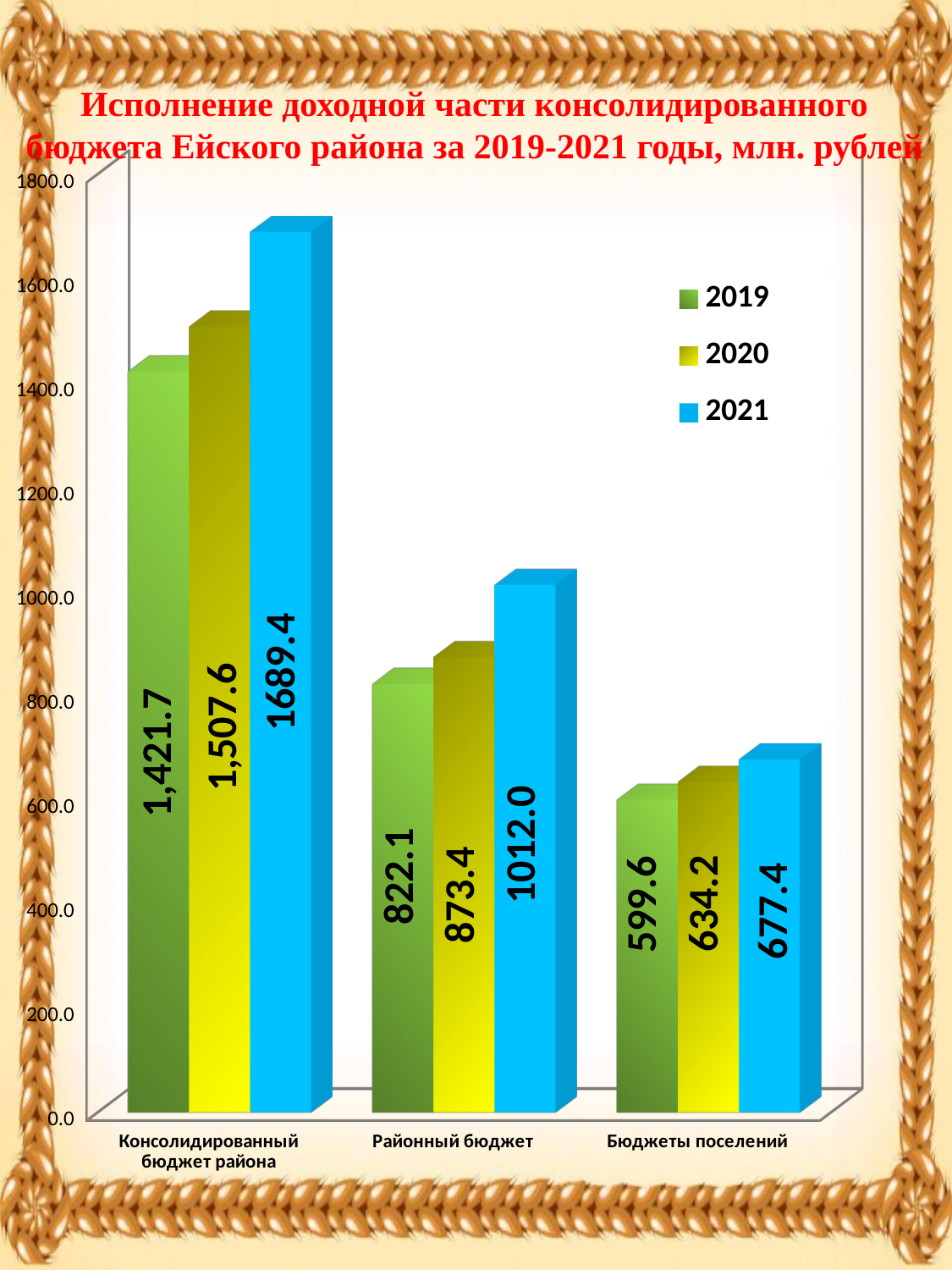
Which category has the highest value for 2019? Консолидированный бюджет района What is the difference between the 2021 and 2019 values for "Районный бюджет"? 189.9 What is the value for 2019 in the "Районный бюджет" category? 822.1 Do the values for "Консолидированный бюджет района" rise or fall from 2019 to 2021? rise How many categories are shown on the x axis? 3 What is the value for 2020 in the "Консолидированный бюджет района" category? 1,507.6 What is the value for 2020 in the "Бюджеты поселений" category? 634.2 What is the value for 2021 in the "Консолидированный бюджет района" category? 1689.4 Which category has the lowest value for 2021? Бюджеты поселений What is the difference between the 2021 and 2019 values for "Бюджеты поселений"? 77.8 Which is larger: the 2020 value for "Районный бюджет" or the 2021 value for "Бюджеты поселений"? 2020 value for Районный бюджет How many series does the legend list? 3